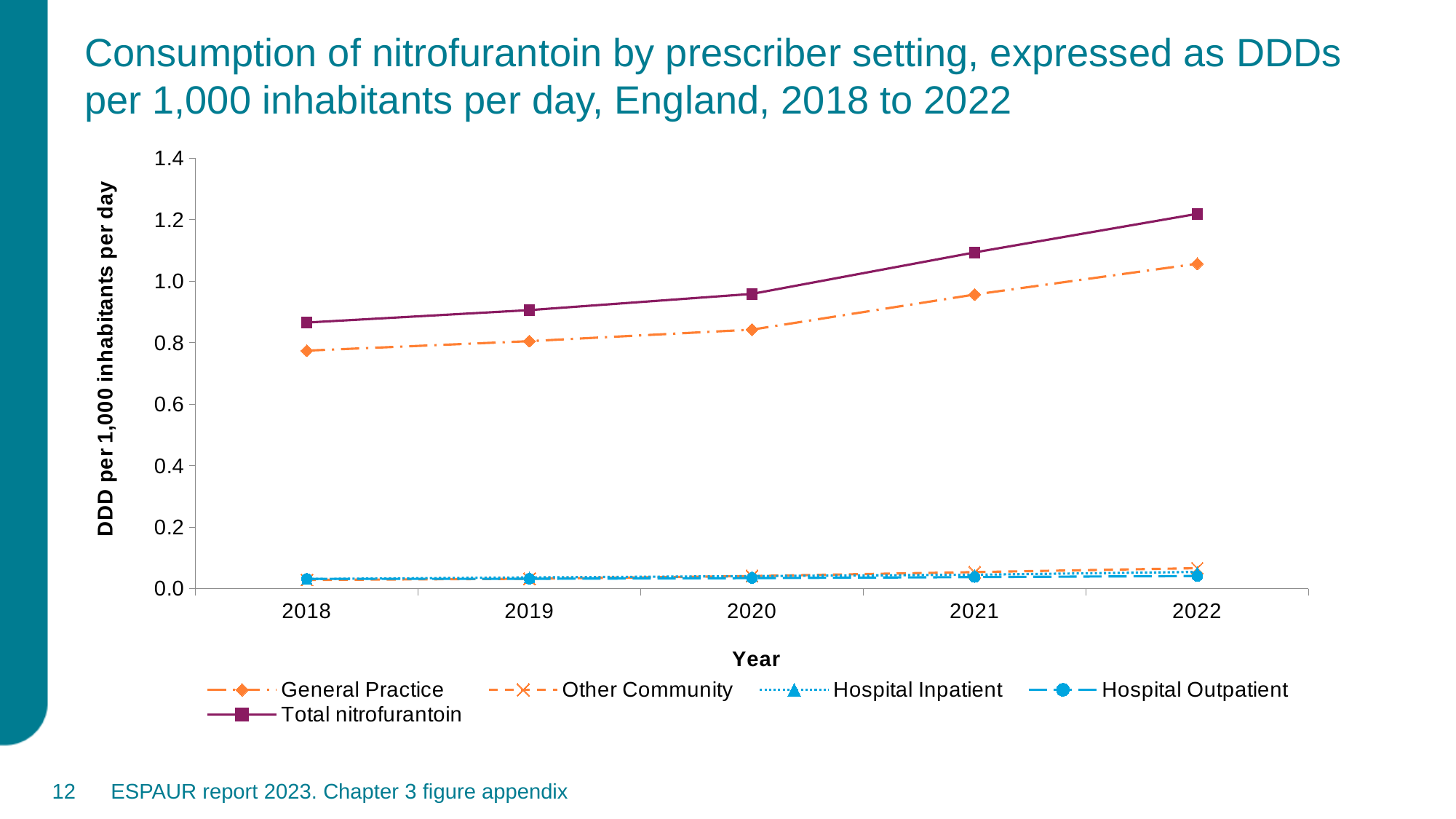
Which series has the highest value in 2022? Total nitrofurantoin Is the value for General Practice in 2018 greater or less than 0.8? less In which year is the Total nitrofurantoin value highest? 2022 Does the Total nitrofurantoin series rise or fall from 2018 to 2022? Rise Is the value for Total nitrofurantoin in 2020 greater or less than 1.0? less Is the value for Total nitrofurantoin in 2022 greater or less than 1.0? greater In which year is the Total nitrofurantoin value lowest? 2018 How many years are plotted along the x axis? 5 What kind of chart is shown on the slide? Line chart Which is larger in 2020, the value for General Practice or the value for Hospital Inpatient? General Practice How many series does the legend list? 5 What is the title of the x axis? Year